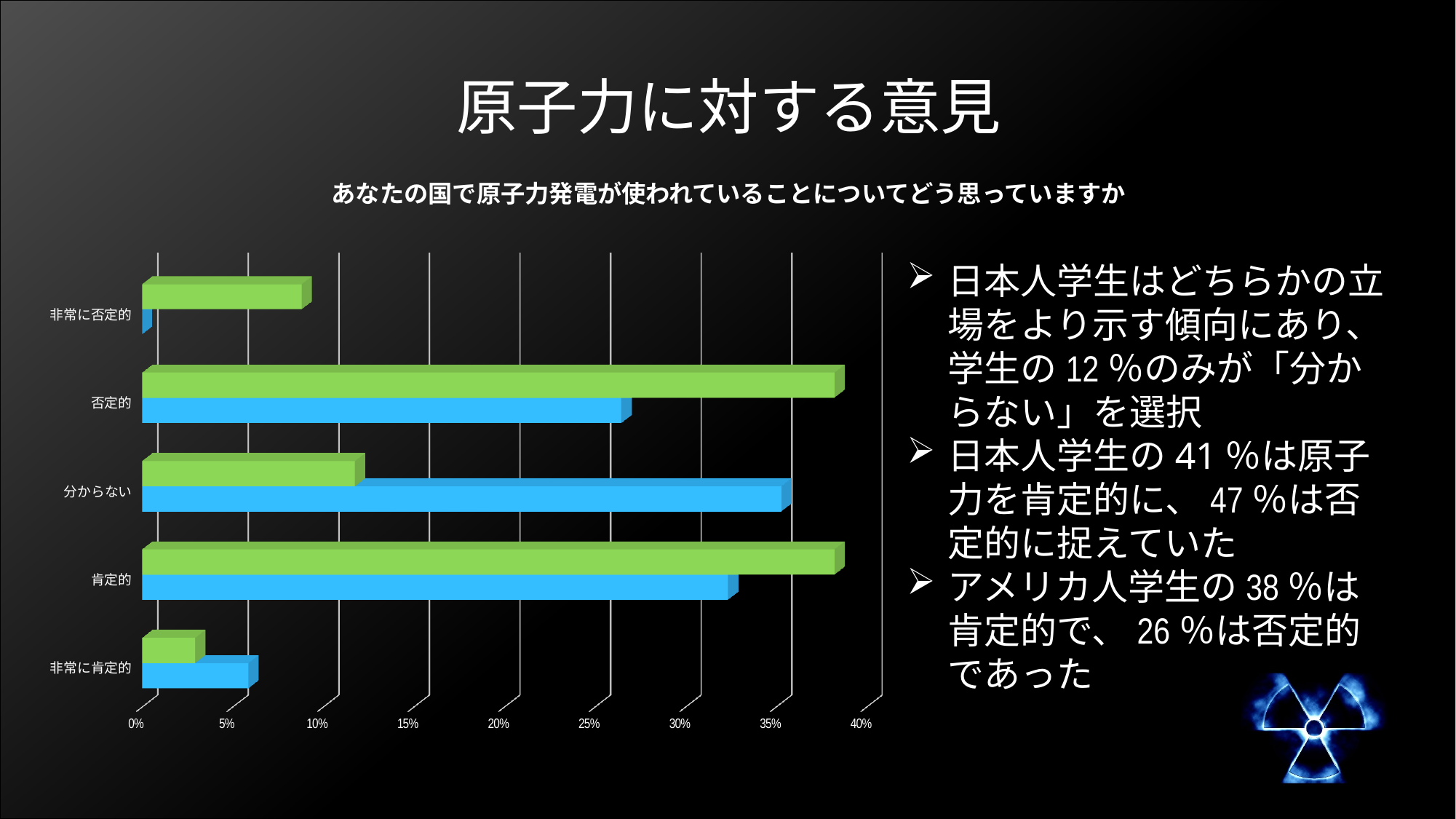
How many data series (bar colours) are plotted in the chart? 2 Which category has the highest value in the blue series? 分からない For 分からない, which bar is larger, the green one or the blue one? blue What is the title of the chart? あなたの国で原子力発電が使われていることについてどう思っていますか Is the blue bar for 否定的 greater or less than 30%? less What kind of chart is shown on the slide? bar chart Is the green bar for 否定的 greater or less than 35%? greater How many categories are shown on the vertical axis of the chart? 5 Is the blue bar for 分からない greater or less than 30%? greater Which category has the lowest value in the green series? 非常に肯定的